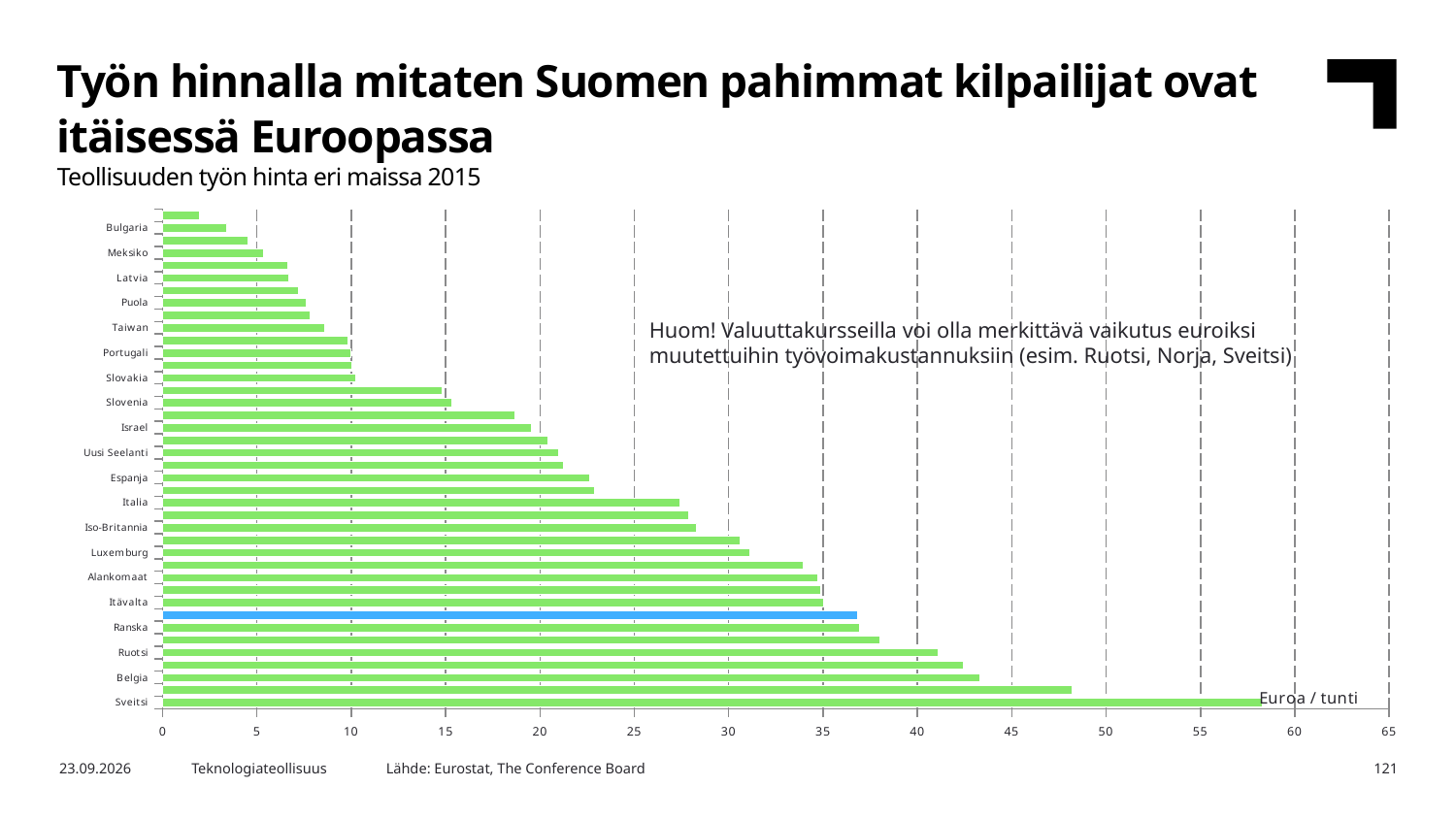
Is the value for Bulgaria greater or less than 5? less Which has a higher value, Latvia or Ruotsi? Ruotsi Is the value for Taiwan greater or less than 10? less Is the value for Sveitsi greater or less than 55? greater What unit is shown for the values on the chart? Euroa / tunti What kind of chart is shown on the slide? bar chart Which has a higher value, Sveitsi or Puola? Sveitsi What is the subtitle of the chart? Teollisuuden työn hinta eri maissa 2015 Which labelled country has the highest labour cost in the chart? Sveitsi